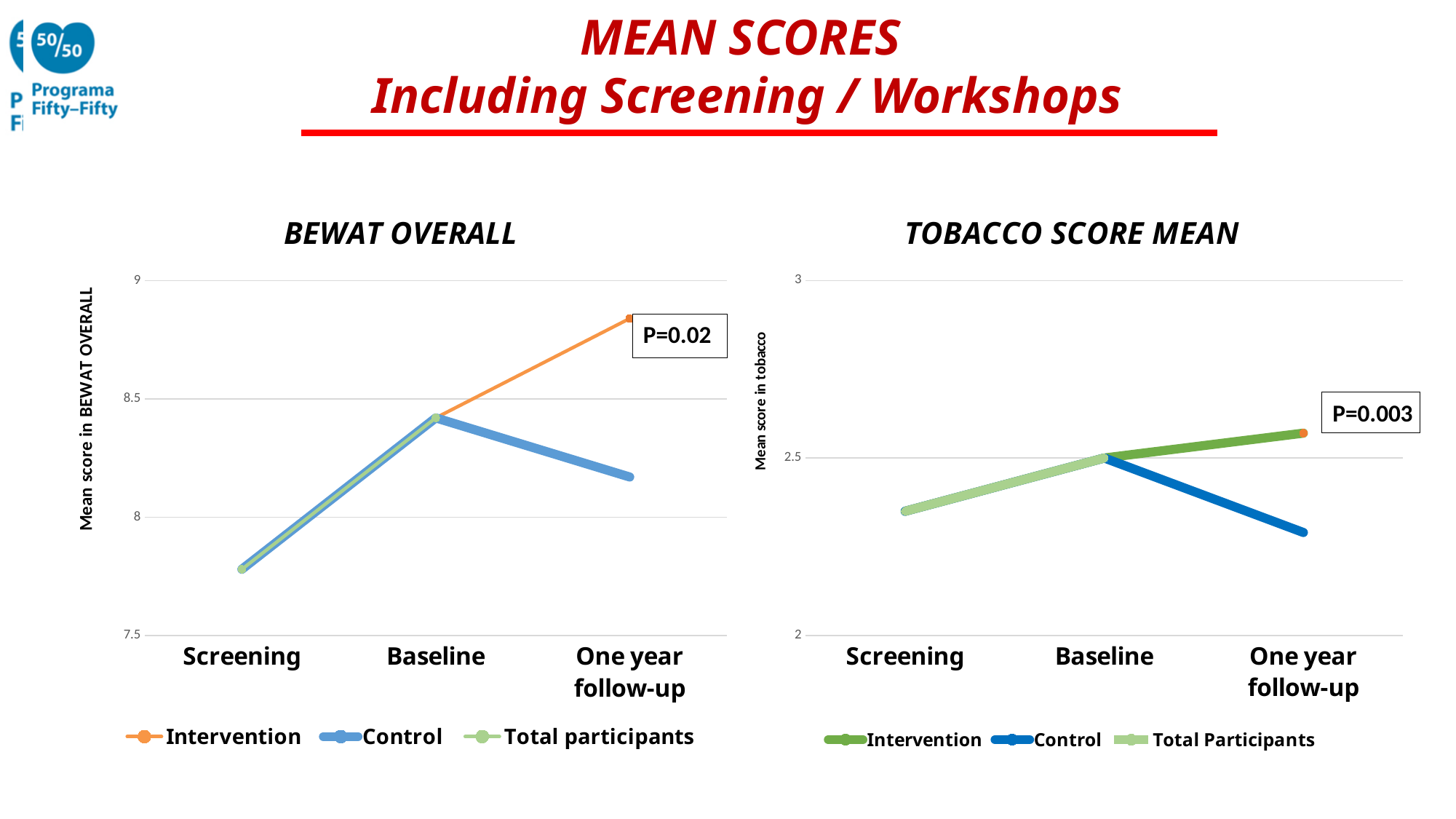
What type of chart is the BEWAT OVERALL chart? line chart How many series does the legend of the TOBACCO SCORE MEAN chart list? 3 In the BEWAT OVERALL chart, which series has the higher value at One year follow-up, Intervention or Control? Intervention In the BEWAT OVERALL chart, is the Control value at One year follow-up greater or less than 8.5? less In the TOBACCO SCORE MEAN chart, does the Control line rise or fall from Baseline to One year follow-up? fall In the BEWAT OVERALL chart, is the Intervention value at One year follow-up greater or less than 8.5? greater In the TOBACCO SCORE MEAN chart, is the Control value at One year follow-up greater or less than 2.5? less What P-value is shown on the BEWAT OVERALL chart? P=0.02 How many time points are shown on the x axis of the BEWAT OVERALL chart? 3 What P-value is shown on the TOBACCO SCORE MEAN chart? P=0.003